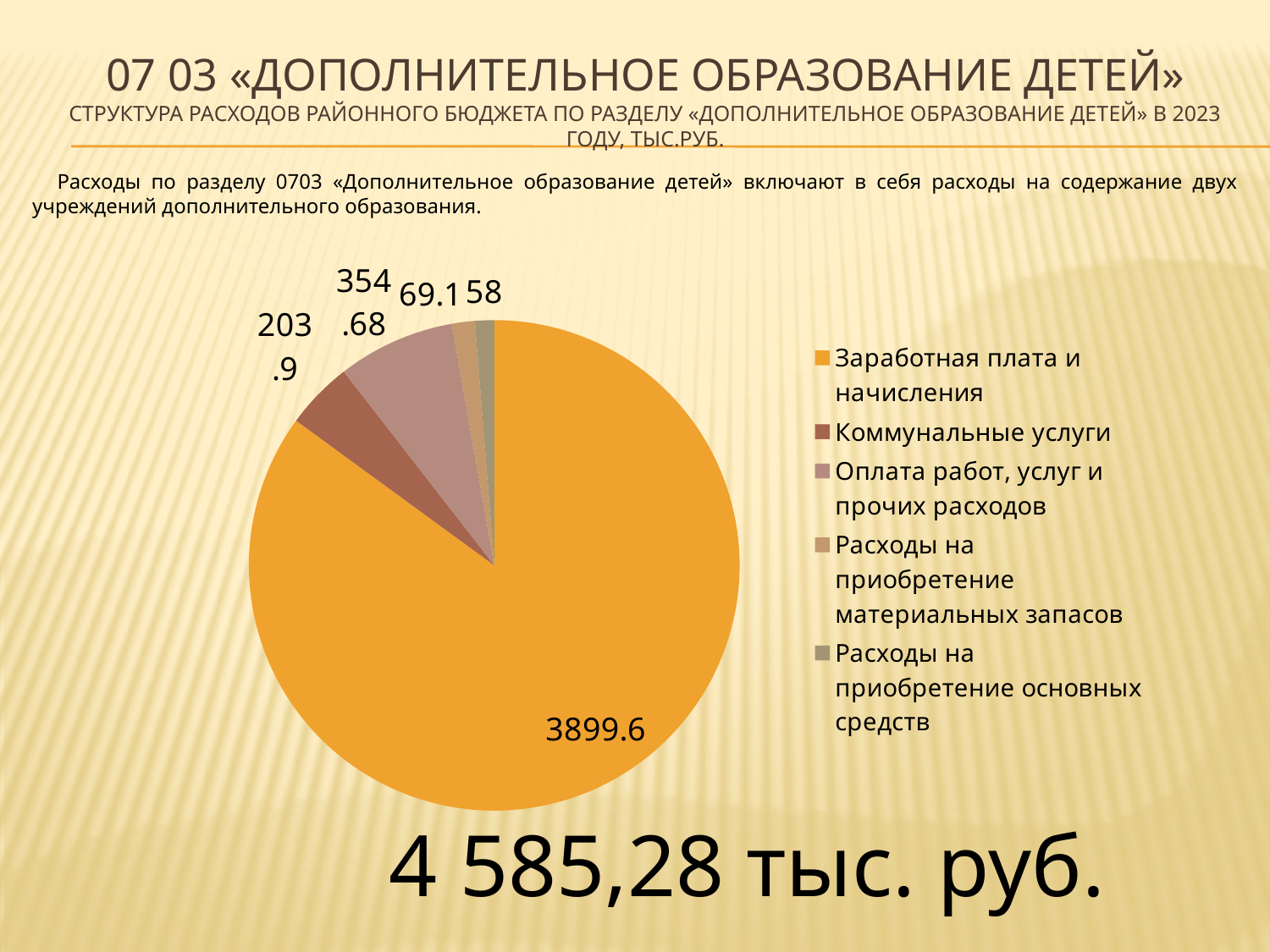
What is the value for «Коммунальные услуги» in the pie chart? 203.9 What total amount in thousand rubles is printed below the pie chart? 4 585,28 тыс. руб. How many slices does the pie chart have? 5 Which is larger in the pie chart: «Коммунальные услуги» or «Оплата работ, услуг и прочих расходов»? Оплата работ, услуг и прочих расходов Which category has the smallest slice in the pie chart? Расходы на приобретение основных средств What is the difference between «Оплата работ, услуг и прочих расходов» and «Коммунальные услуги» in the pie chart? 150.78 What is the value for «Заработная плата и начисления» in the pie chart? 3899.6 Which category has the largest slice in the pie chart? Заработная плата и начисления What is the value for «Оплата работ, услуг и прочих расходов» in the pie chart? 354.68 What type of chart is shown on the slide? pie chart What is the value for «Расходы на приобретение основных средств» in the pie chart? 58 How many entries does the legend of the pie chart list? 5